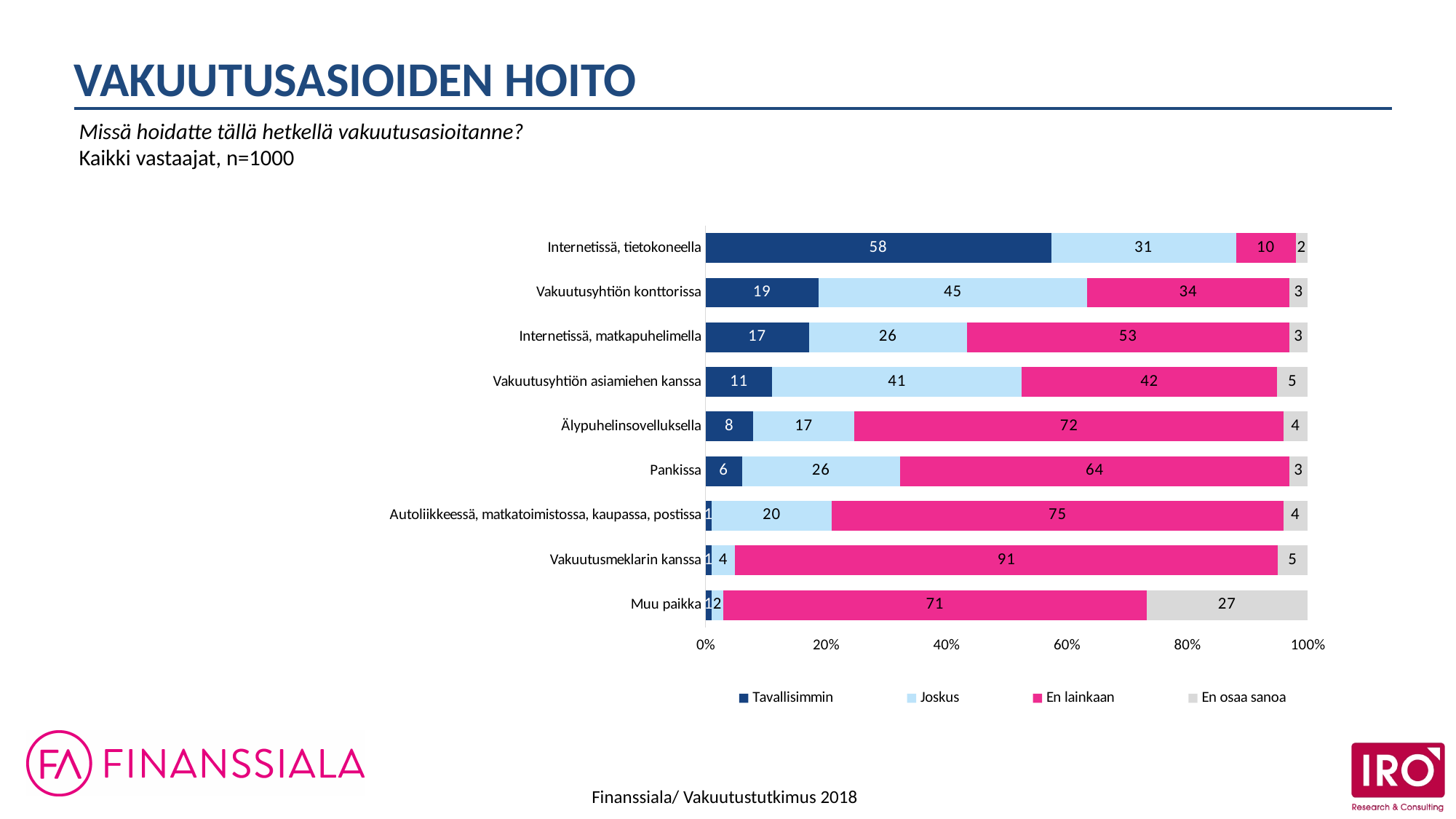
Which category has the highest Tavallisimmin value? Internetissä, tietokoneella What is the En osaa sanoa value for Muu paikka? 27 What is the total of the stacked bar for Autoliikkeessä, matkatoimistossa, kaupassa, postissa? 100 What is the difference between the En lainkaan values for Älypuhelinsovelluksella and Pankissa? 8 What kind of chart is shown on the slide? Stacked bar chart What is the En lainkaan value for Vakuutusmeklarin kanssa? 91 How many categories are plotted on the chart? 9 Which is larger, the Joskus value for Vakuutusyhtiön asiamiehen kanssa or for Internetissä, matkapuhelimella? Vakuutusyhtiön asiamiehen kanssa How many series does the legend list? 4 Which category has the lowest En lainkaan value? Internetissä, tietokoneella What is the Joskus value for Vakuutusyhtiön konttorissa? 45 What is the Tavallisimmin value for Internetissä, tietokoneella? 58